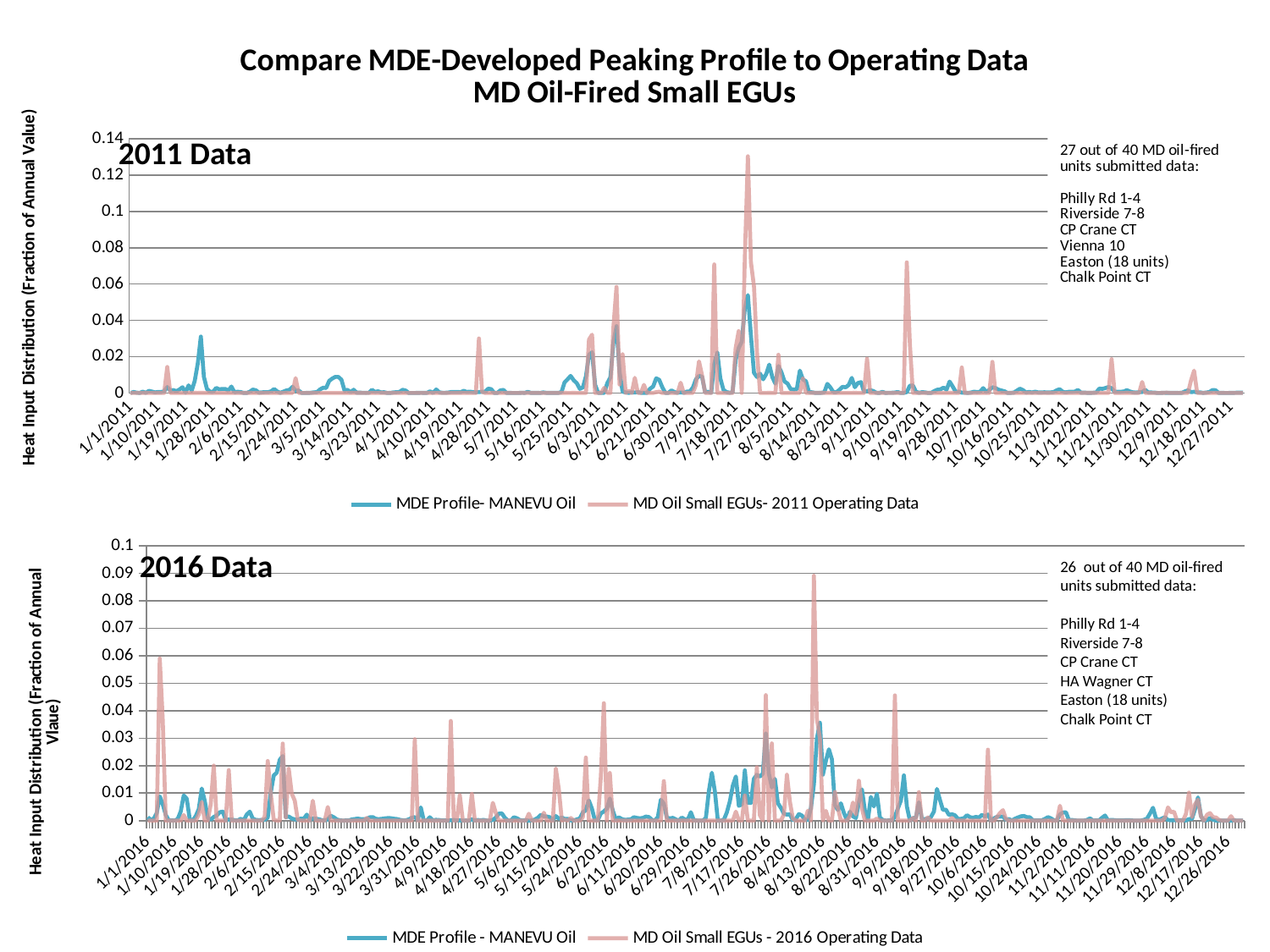
In the 2011 Data chart, which series reaches the highest peak? MD Oil Small EGUs- 2011 Operating Data What is the highest value shown on the y axis of the 2016 Data chart? 0.1 In the 2011 Data chart, is the peak of the MDE Profile- MANEVU Oil series near 1/28/2011 greater or less than 0.02? greater In the 2016 Data chart, is the peak of the MD Oil Small EGUs - 2016 Operating Data series near 1/10/2016 greater or less than 0.05? greater What kind of chart is the 2011 Data chart? line chart In the 2016 Data chart, is the highest peak of the MD Oil Small EGUs - 2016 Operating Data series greater or less than 0.08? greater How many series does the legend of the 2016 Data chart list? 2 In the 2016 Data chart, which series reaches the highest peak? MD Oil Small EGUs - 2016 Operating Data What colour is the MDE Profile- MANEVU Oil line in the 2011 Data chart? blue In the 2011 Data chart, which series is larger at its peak near 7/27/2011: MDE Profile- MANEVU Oil or MD Oil Small EGUs- 2011 Operating Data? MD Oil Small EGUs- 2011 Operating Data